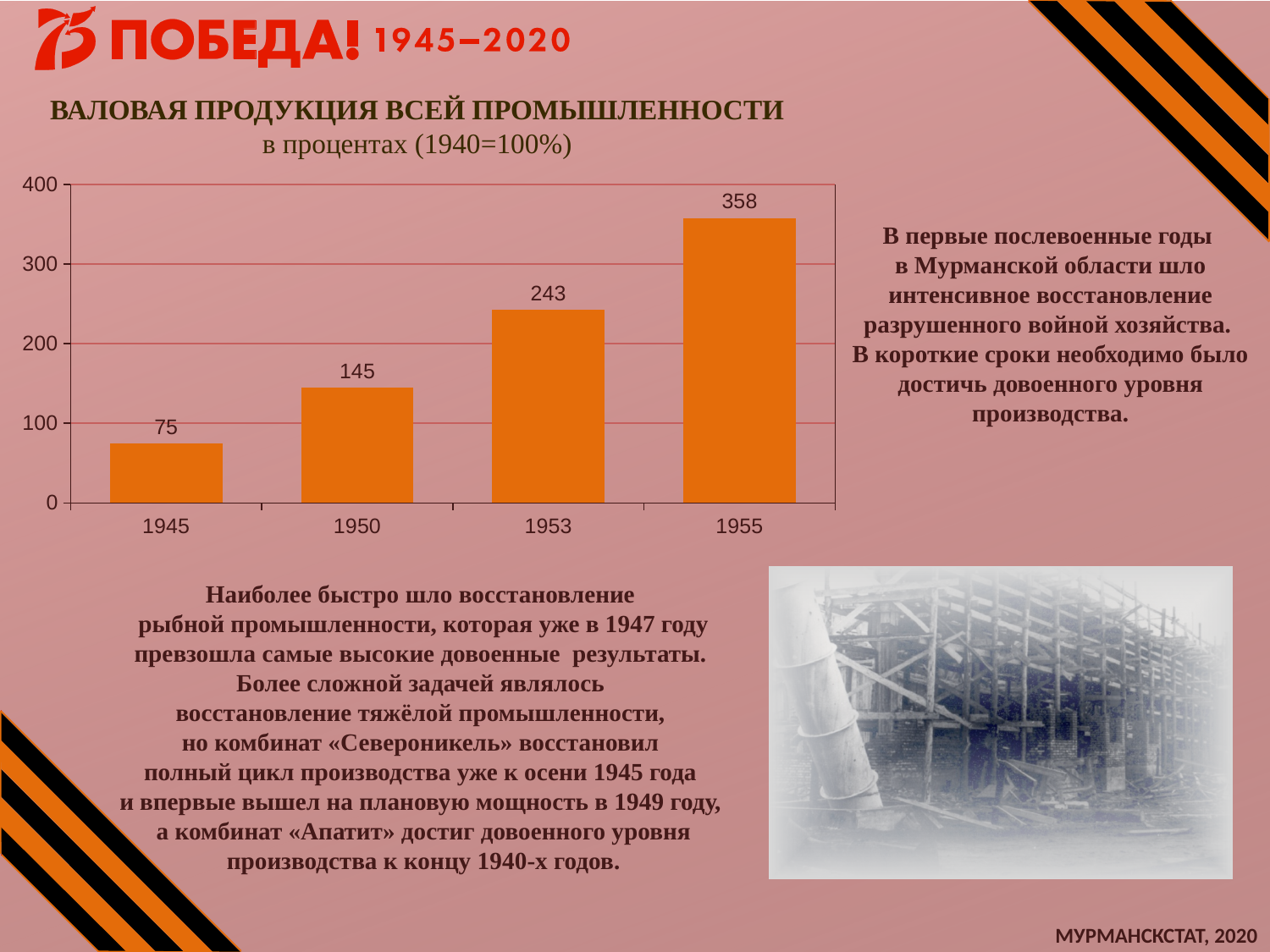
What is the value for 1955? 358 How many years are shown on the x axis? 4 What is the difference between the values for 1953 and 1950? 98 What kind of chart is shown on the slide? bar chart What is the value for 1953? 243 What is the value for 1950? 145 What is the difference between the values for 1955 and 1945? 283 Which year has the lowest value? 1945 What is the value for 1945? 75 Which year has the highest value? 1955 Do the values rise or fall from 1945 to 1955? rise Which is larger, the value for 1950 or the value for 1953? 1953